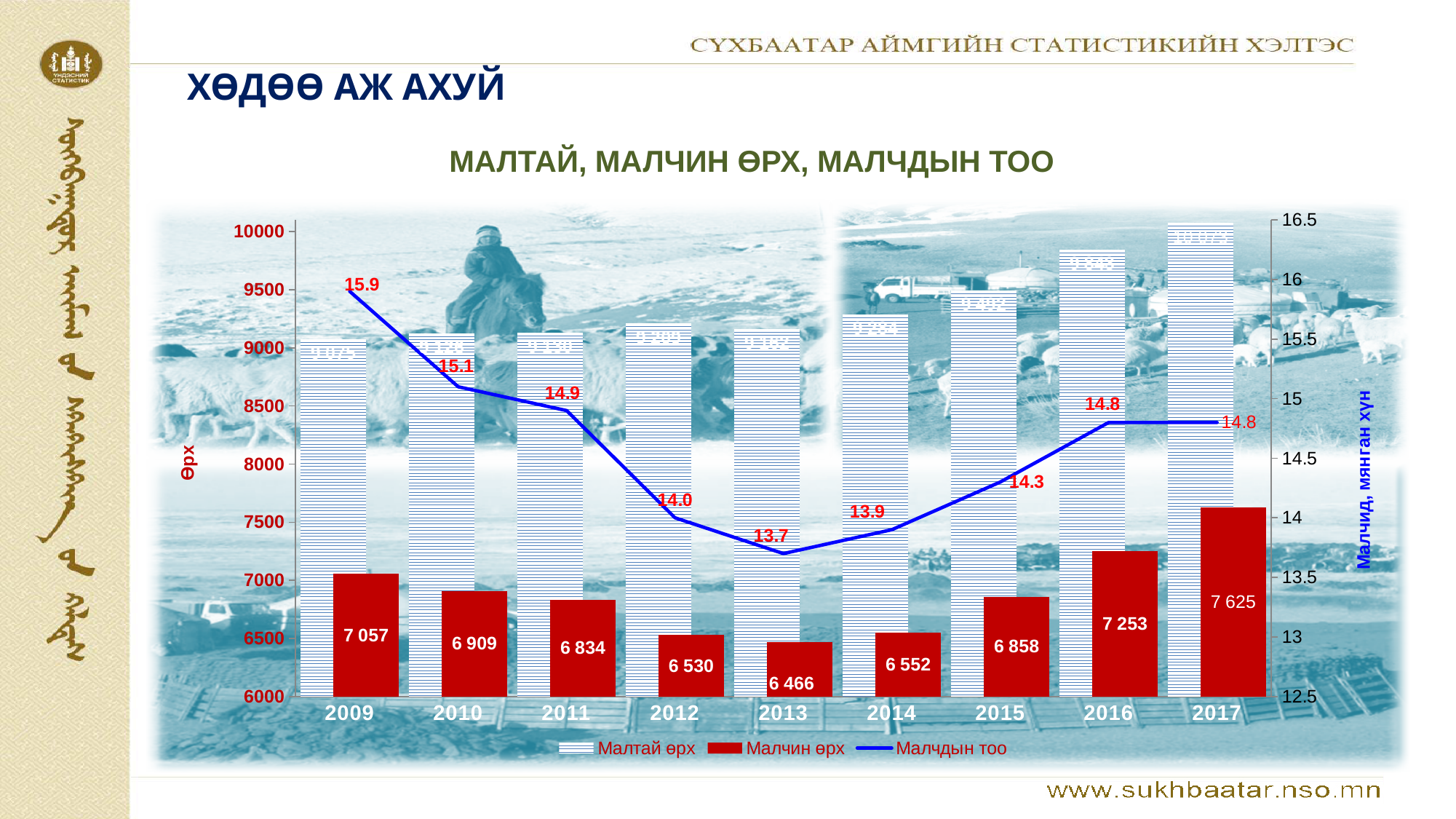
What is the value of Малчин өрх in 2017? 7 625 What is the value of Малчдын тоо in 2009? 15.9 What kind of chart is this? Combined bar and line chart What is the difference between Малчин өрх in 2017 and in 2016? 372 In which year is Малчин өрх lowest? 2013 In which year is Малчин өрх highest? 2017 In which year is Малчдын тоо lowest? 2013 What is the value of Малчдын тоо in 2015? 14.3 Does Малчдын тоо rise or fall from 2009 to 2013? Fall Which is larger, Малчин өрх in 2010 or in 2014? 2010 How many series does the legend list? 3 How many years are shown on the x axis? 9